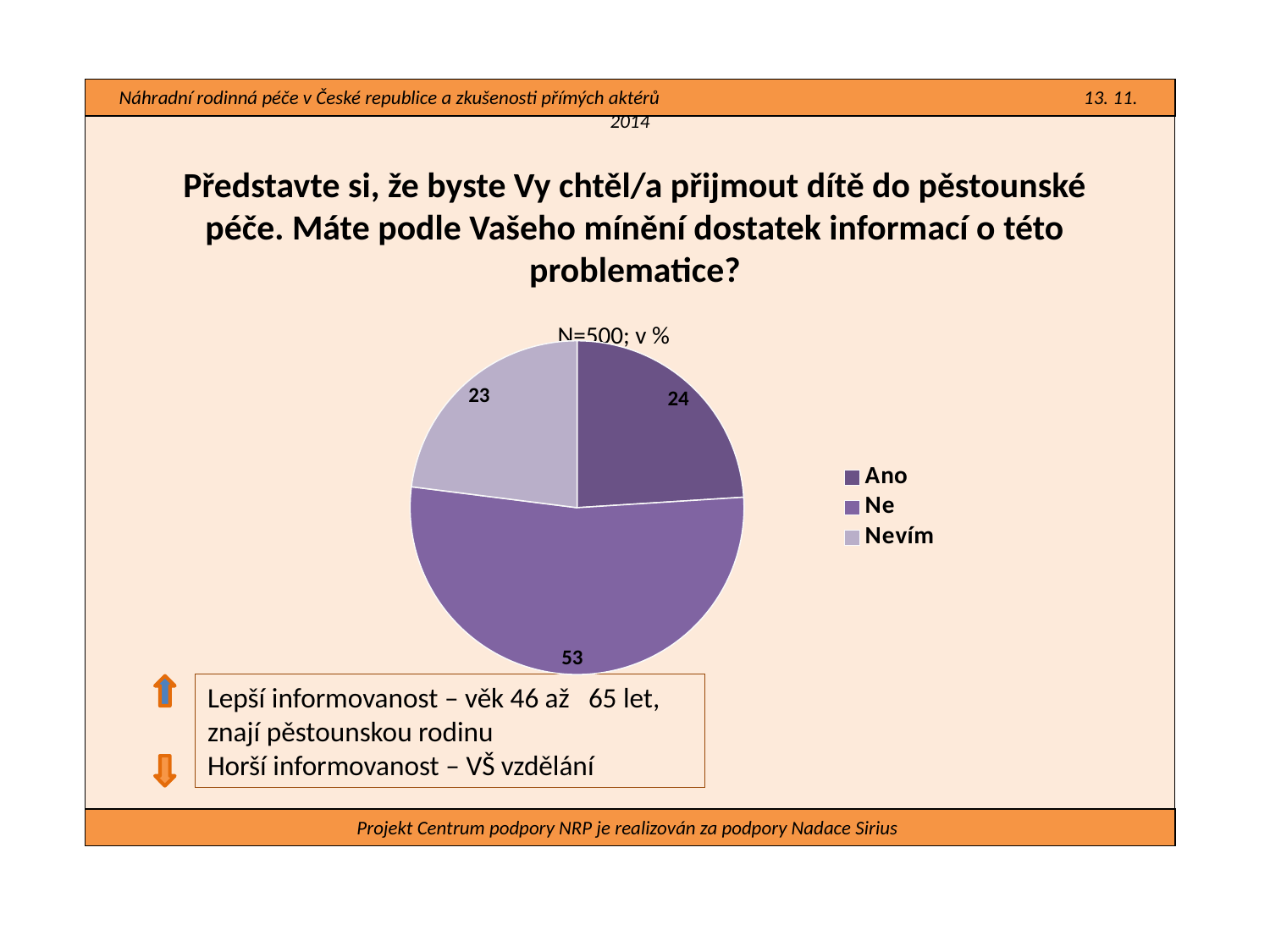
Which is larger, the value for Ne or the value for Nevím? Ne What is the value for Ne in the pie chart? 53 Which category has the smallest slice in the pie chart? Nevím What are the legend entries of the pie chart? Ano, Ne, Nevím What is the value for Nevím in the pie chart? 23 What is the difference between the values for Ne and Ano? 29 What kind of chart is shown on the slide? pie chart How many categories does the pie chart show? 3 What is the value for Ano in the pie chart? 24 What is the title of the pie chart? N=500; v % Which category has the largest slice in the pie chart? Ne What is the difference between the values for Ano and Nevím? 1